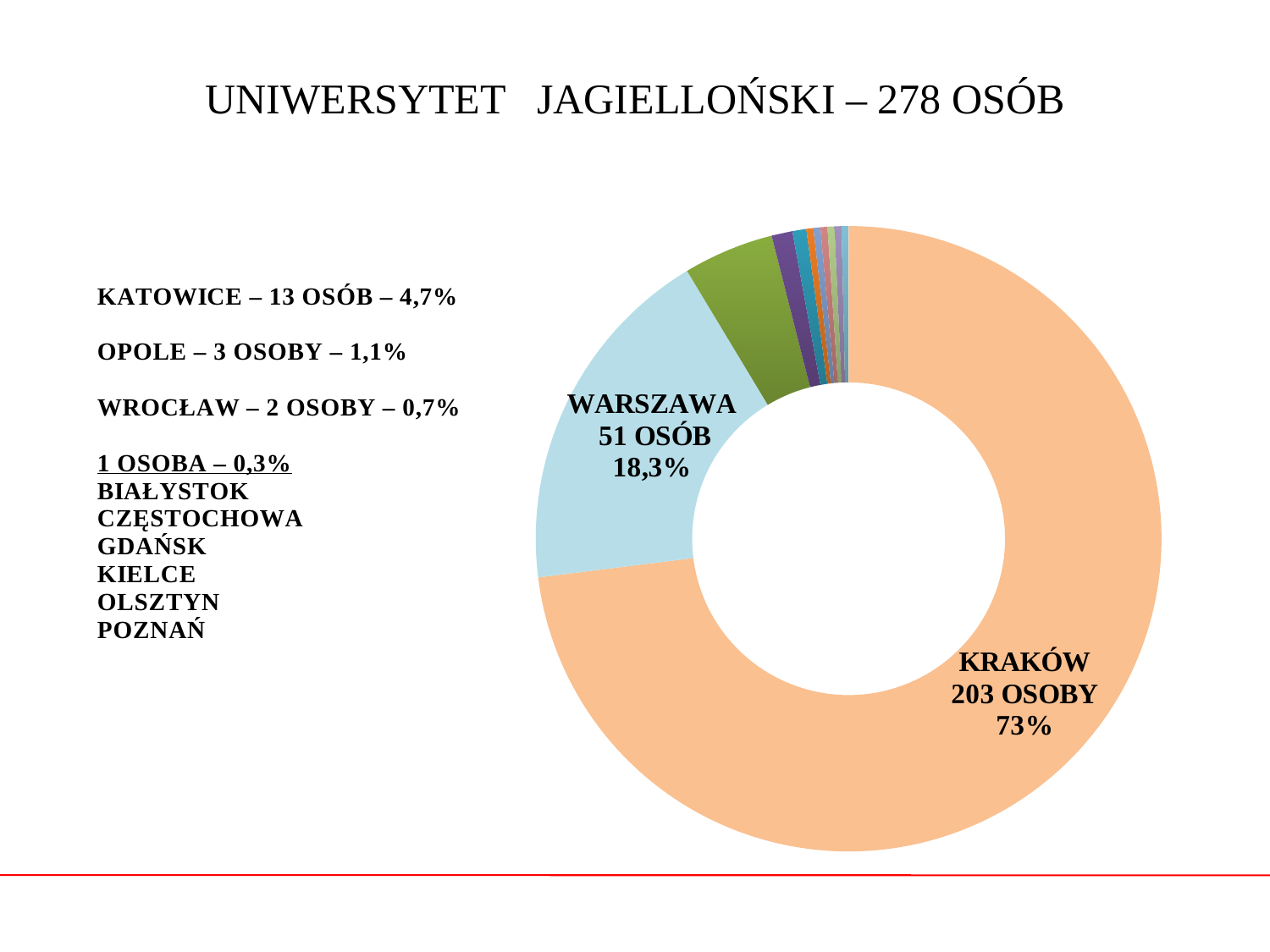
What kind of chart is shown on the slide? doughnut chart How many people does Opole represent? 3 osoby What share of the pie does Kraków account for? 73% What is the total number of people represented by the chart, according to the slide title? 278 osób What is the difference in number of people between Kraków and Warszawa? 152 Which is larger, the slice for Warszawa or the slice for Katowice? Warszawa What is the title of the slide? UNIWERSYTET JAGIELLOŃSKI – 278 OSÓB Which city has the largest slice of the pie? Kraków What share of the pie does Katowice account for? 4,7% How many people does the Warszawa slice represent? 51 osób What share of the pie does Warszawa account for? 18,3% How many people does the Kraków slice represent? 203 osoby